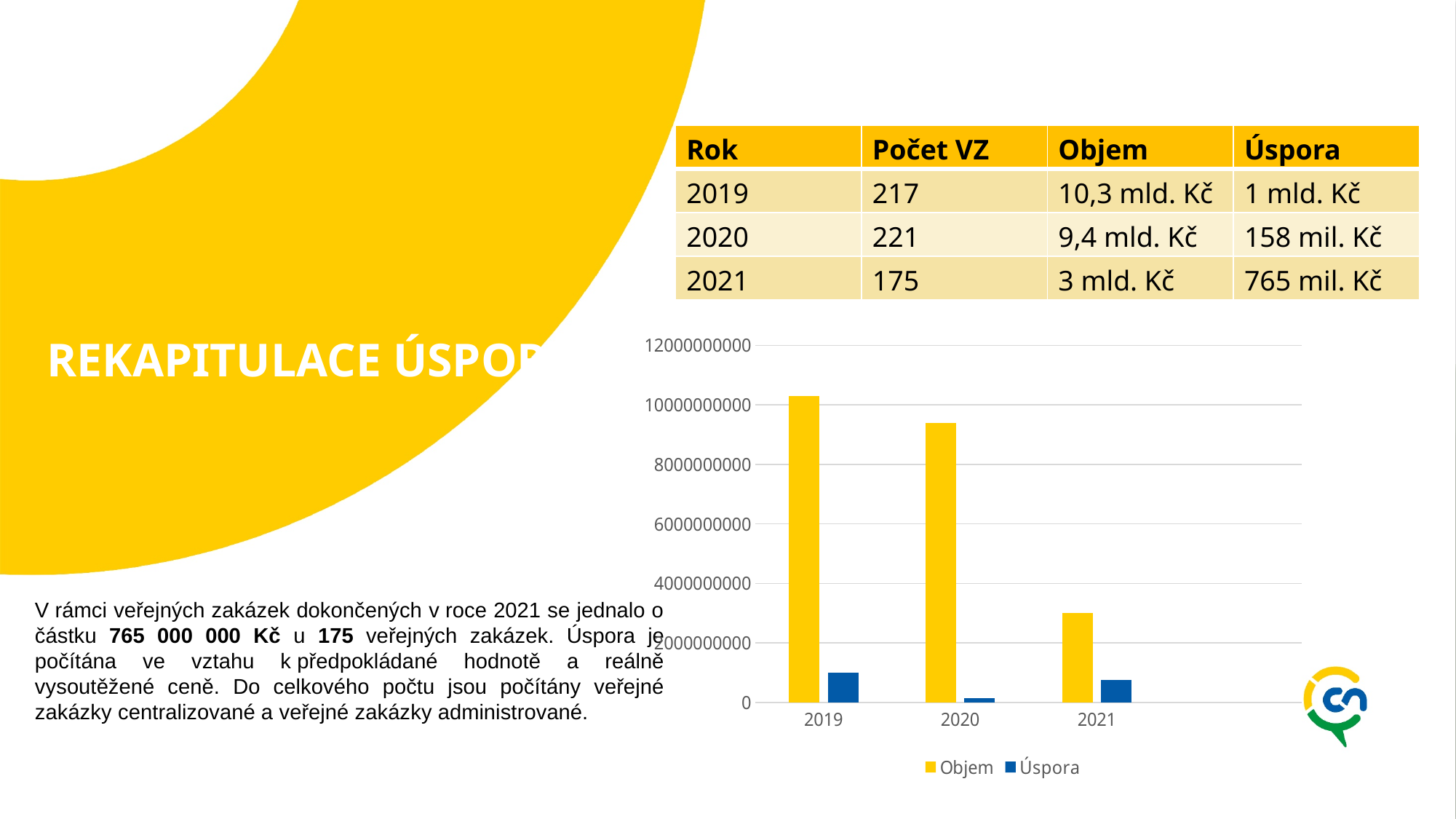
Do the Objem bars rise or fall from 2019 to 2021? fall How many years are shown on the x axis of the chart? 3 What colour are the Objem bars in the chart? yellow Is the Objem value for 2020 greater or less than 10000000000? less How many series does the chart legend list? 2 Is the Objem value for 2021 greater or less than 4000000000? less Which year has the highest Objem bar in the chart? 2019 Which is larger in the chart: the Úspora bar for 2019 or the Úspora bar for 2021? 2019 Which year has the highest Úspora bar in the chart? 2019 What kind of chart is shown on the slide? bar chart Which year has the lowest Objem bar in the chart? 2021 Which year has the lowest Úspora bar in the chart? 2020